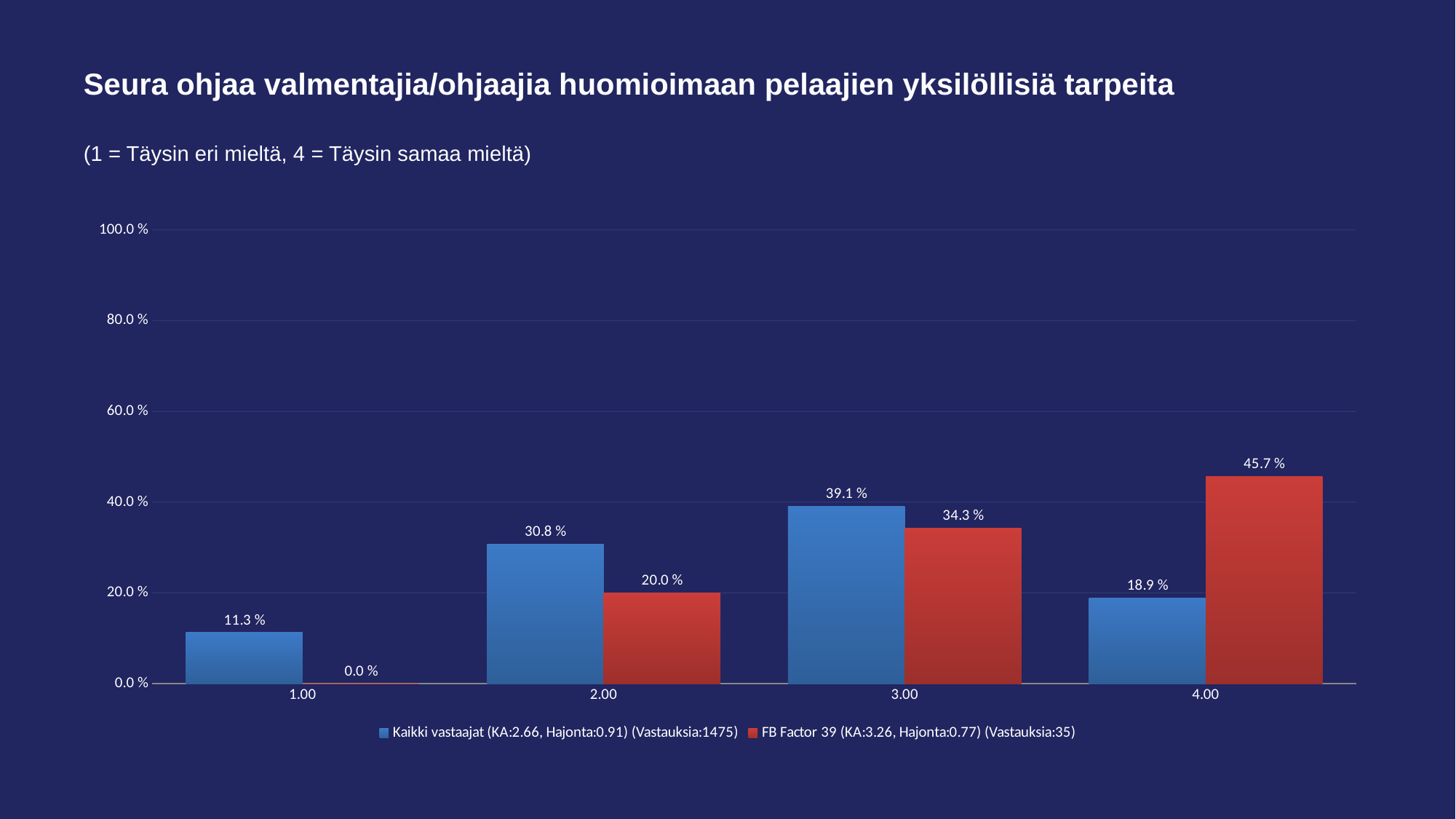
How many series does the legend list? 2 At category 2.00, which series has the larger value, Kaikki vastaajat or FB Factor 39? Kaikki vastaajat Which category has the lowest value for the FB Factor 39 series? 1.00 What is the value for FB Factor 39 at category 4.00? 45.7 % What kind of chart is shown on the slide? Bar chart What is the difference between the FB Factor 39 value and the Kaikki vastaajat value at category 4.00? 26.8 % What is the value for Kaikki vastaajat at category 3.00? 39.1 % Which category has the highest value for the Kaikki vastaajat series? 3.00 Is the value for FB Factor 39 at category 3.00 greater or less than 40.0 %? less How many categories are shown on the x axis? 4 Do the values for the FB Factor 39 series rise or fall from category 1.00 to 4.00? Rise What is the value for FB Factor 39 at category 1.00? 0.0 %